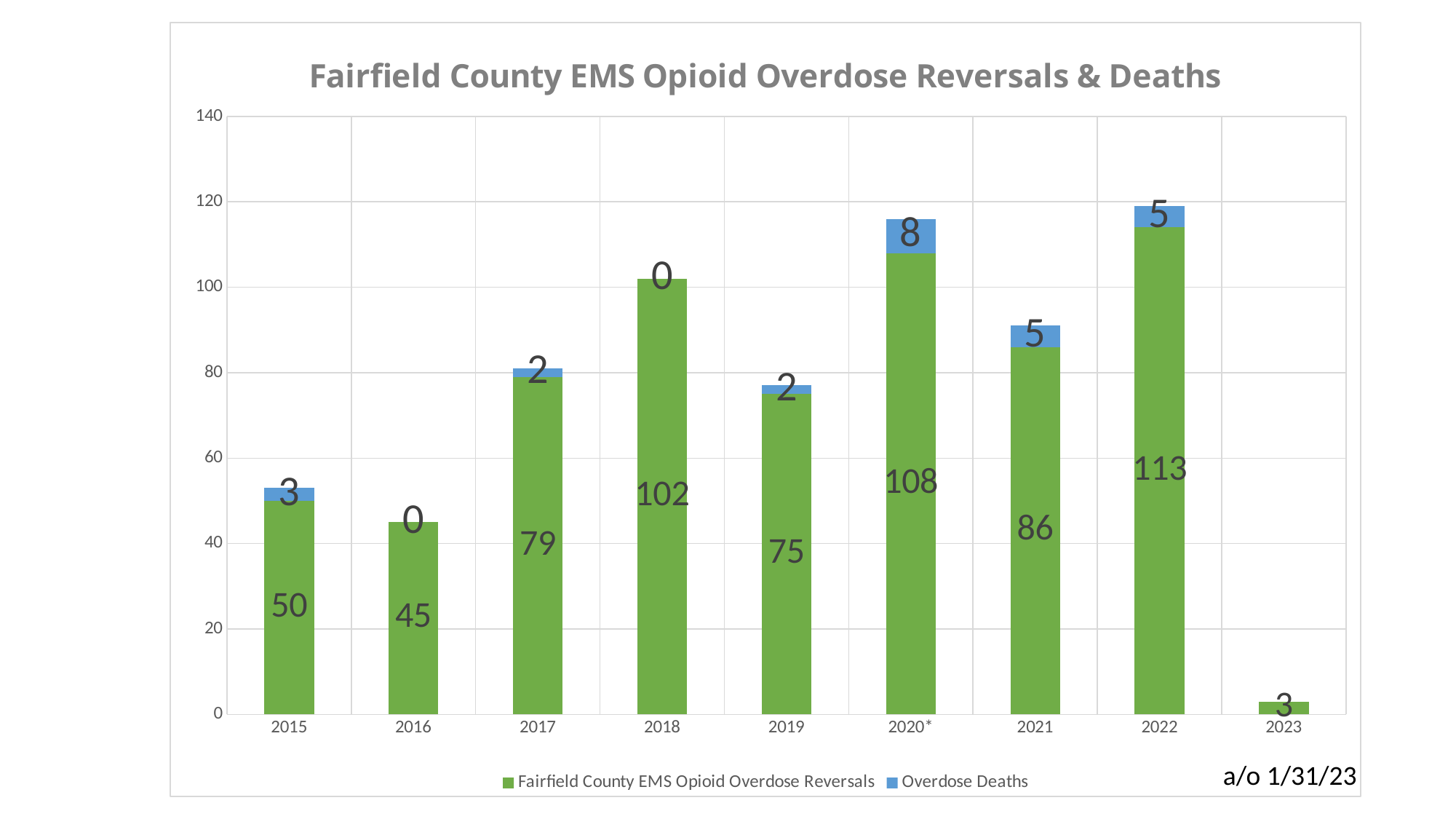
What kind of chart is shown on the slide? Stacked bar chart How many years are shown on the x axis? 9 Which year had more Fairfield County EMS Opioid Overdose Reversals, 2017 or 2019? 2017 What is the difference in Fairfield County EMS Opioid Overdose Reversals between 2022 and 2021? 27 How many Overdose Deaths were there in 2020*? 8 How many Fairfield County EMS Opioid Overdose Reversals were there in 2018? 102 What is the title of the chart? Fairfield County EMS Opioid Overdose Reversals & Deaths How many series does the legend list? 2 Did Fairfield County EMS Opioid Overdose Reversals rise or fall from 2015 to 2016? Fall Which year had the highest number of Fairfield County EMS Opioid Overdose Reversals? 2022 What is the total of the stacked bar for 2020* (reversals plus deaths)? 116 Which year had the lowest number of Fairfield County EMS Opioid Overdose Reversals? 2023